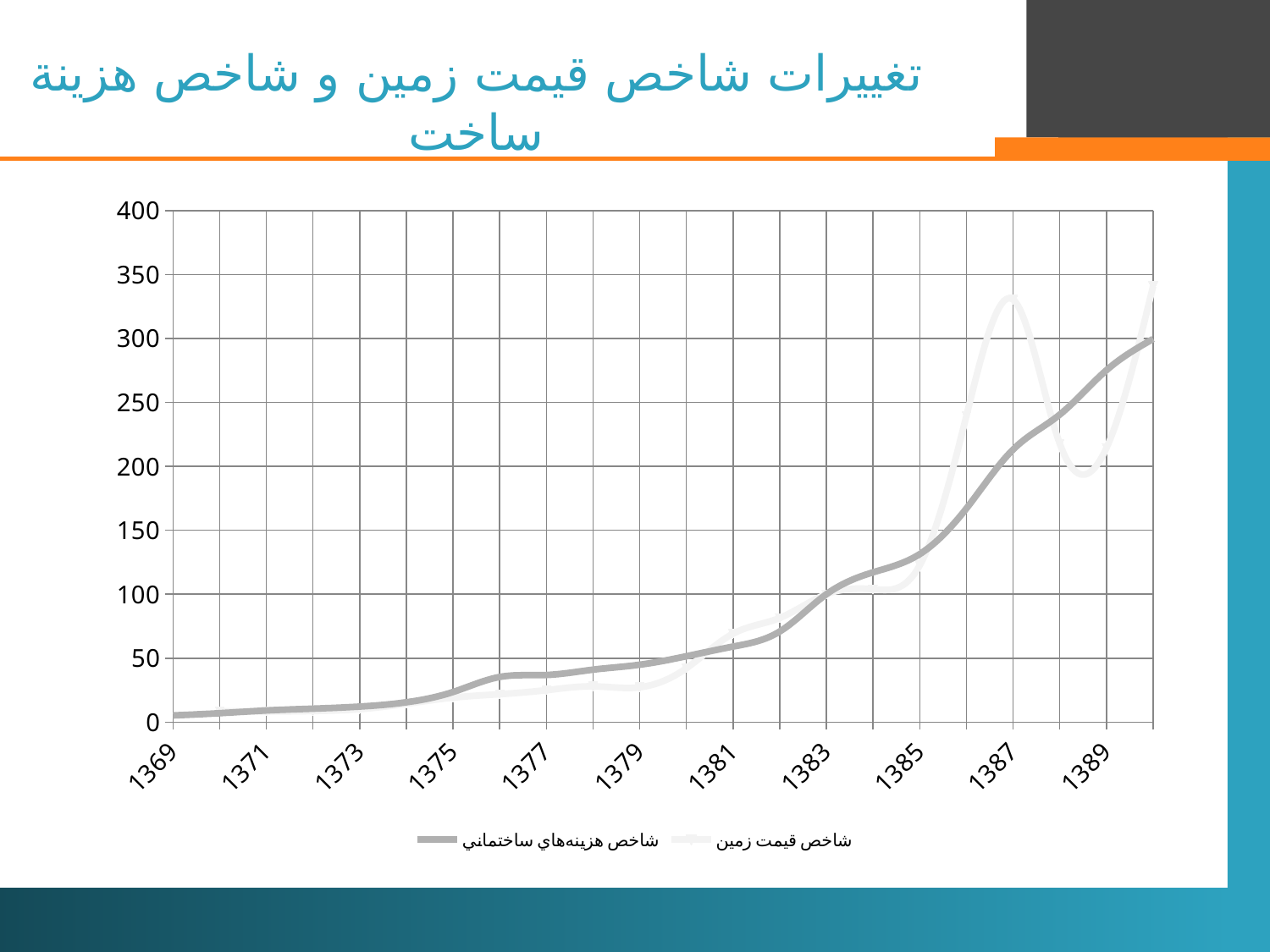
How many series does the legend list? 2 Is the value of شاخص هزینه‌های ساختمانی at 1389 greater or less than 250? greater At 1387, which series has the higher value, شاخص قیمت زمین or شاخص هزینه‌های ساختمانی? شاخص قیمت زمین At 1376, which series has the higher value, شاخص قیمت زمین or شاخص هزینه‌های ساختمانی? شاخص هزینه‌های ساختمانی Does شاخص هزینه‌های ساختمانی generally rise or fall from 1369 to 1390? rise Which two series are listed in the legend? شاخص هزینه‌های ساختمانی and شاخص قیمت زمین Is the value of شاخص هزینه‌های ساختمانی at 1369 greater or less than 50? less Is the value of شاخص هزینه‌های ساختمانی at 1385 greater or less than 100? greater What kind of chart is shown on the slide? line chart What is the highest value shown on the vertical axis? 400